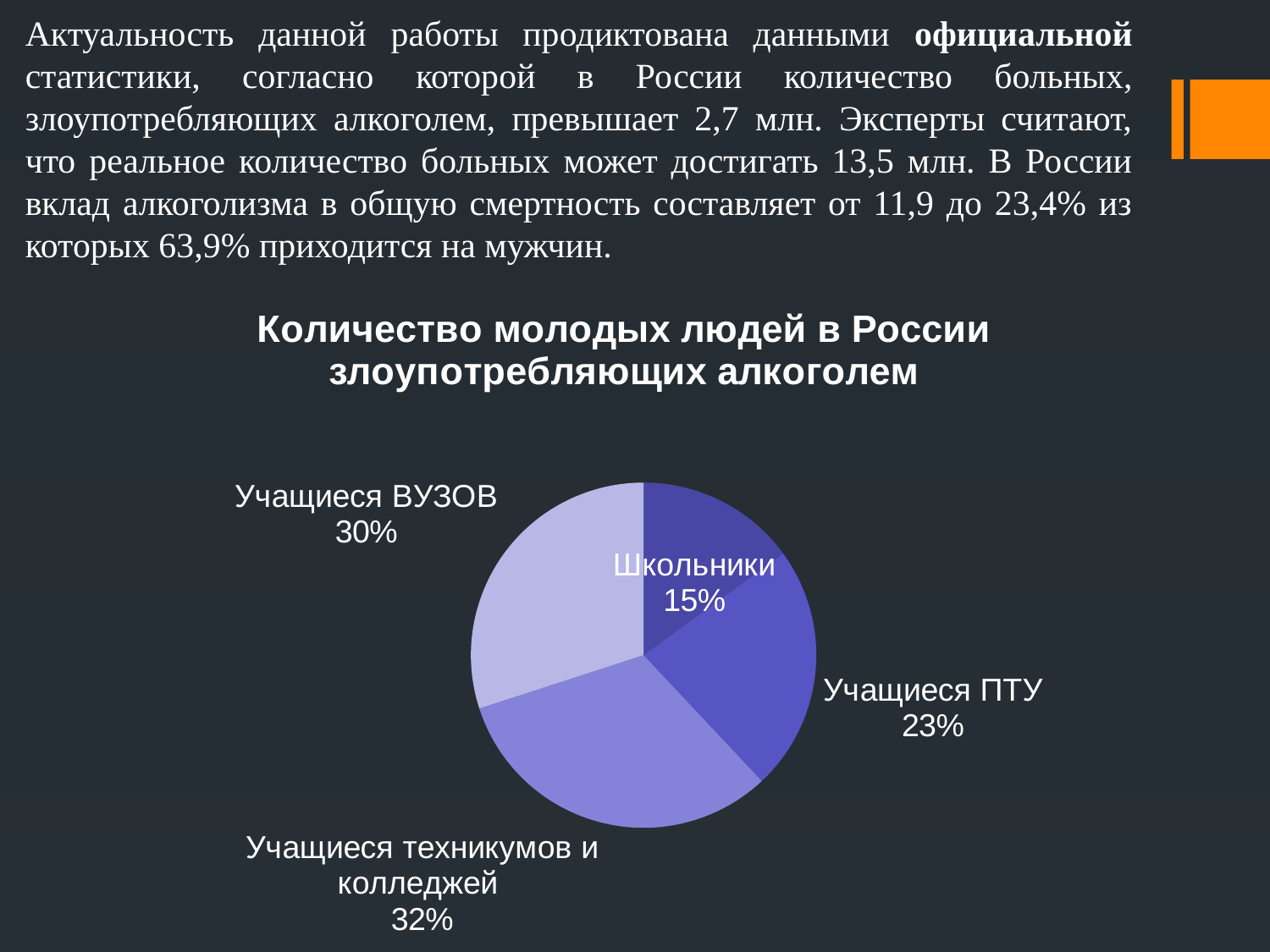
What share of the pie is labelled Школьники? 15% What is the difference between the shares for Учащиеся техникумов и колледжей and Учащиеся ПТУ? 9% Which category has the smallest slice of the pie? Школьники What is the difference between the shares for Учащиеся ВУЗОВ and Школьники? 15% What type of chart is shown on the slide? pie chart What is the title of the chart? Количество молодых людей в России злоупотребляющих алкоголем What share of the pie is labelled Учащиеся ВУЗОВ? 30% How many categories are shown in the pie chart? 4 Which category has the largest slice of the pie? Учащиеся техникумов и колледжей What share of the pie is labelled Учащиеся ПТУ? 23% What share of the pie is labelled Учащиеся техникумов и колледжей? 32% Which is larger, the share for Учащиеся ПТУ or the share for Учащиеся ВУЗОВ? Учащиеся ВУЗОВ